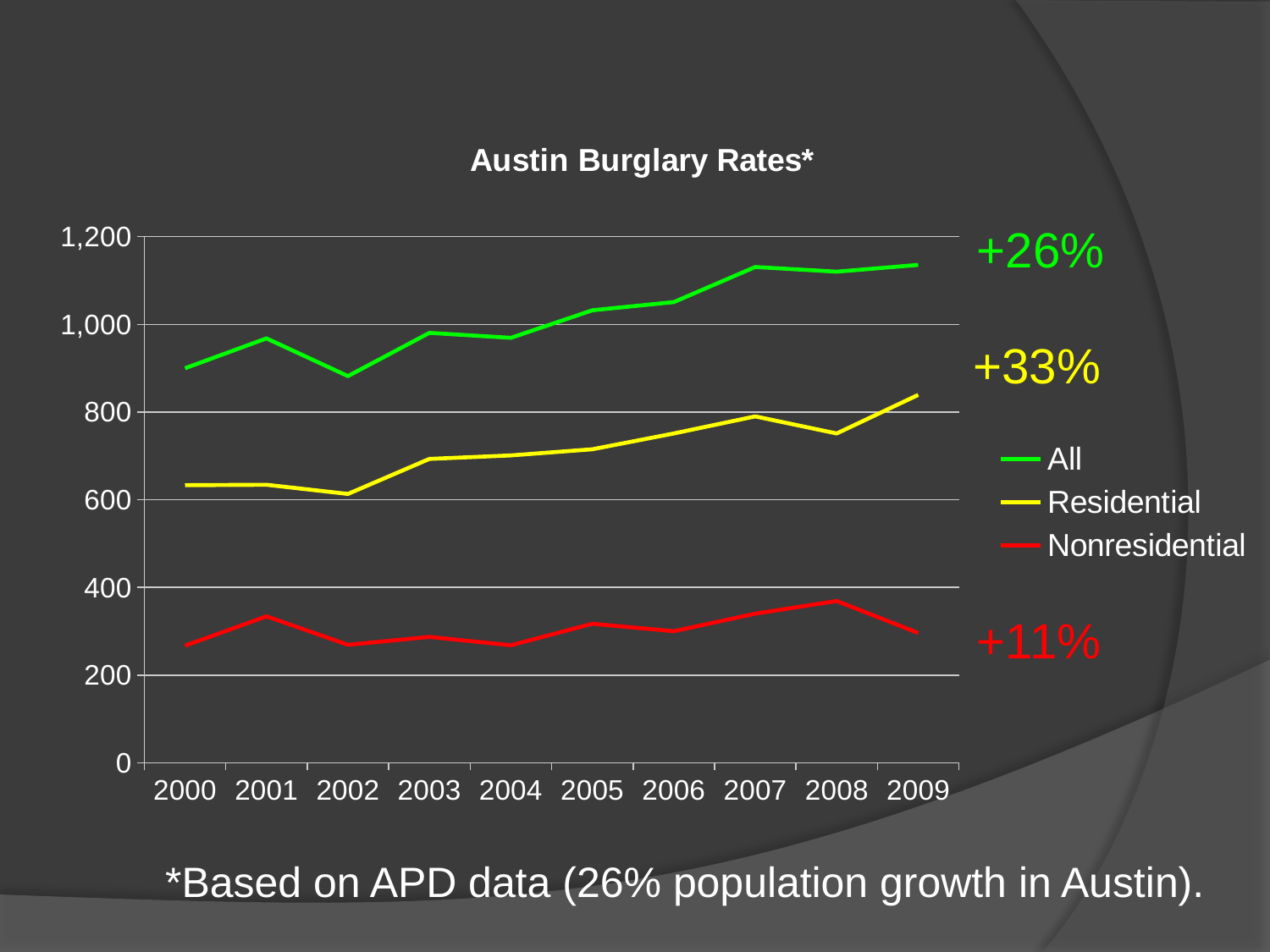
In which year is the Nonresidential series at its highest? 2008 Is the value for Nonresidential in 2008 greater or less than 400? less Does the All series generally rise or fall from 2000 to 2009? rise How many years are plotted along the x axis? 10 What kind of chart is shown on the slide? line chart In which year is the Residential series at its highest? 2009 Which series has the larger value in 2005, All or Nonresidential? All How many series does the legend list? 3 What percentage change is annotated next to the Residential line? +33% Is the value for All in 2007 greater or less than 1,000? greater Is the value for All in 2000 greater or less than 1,000? less